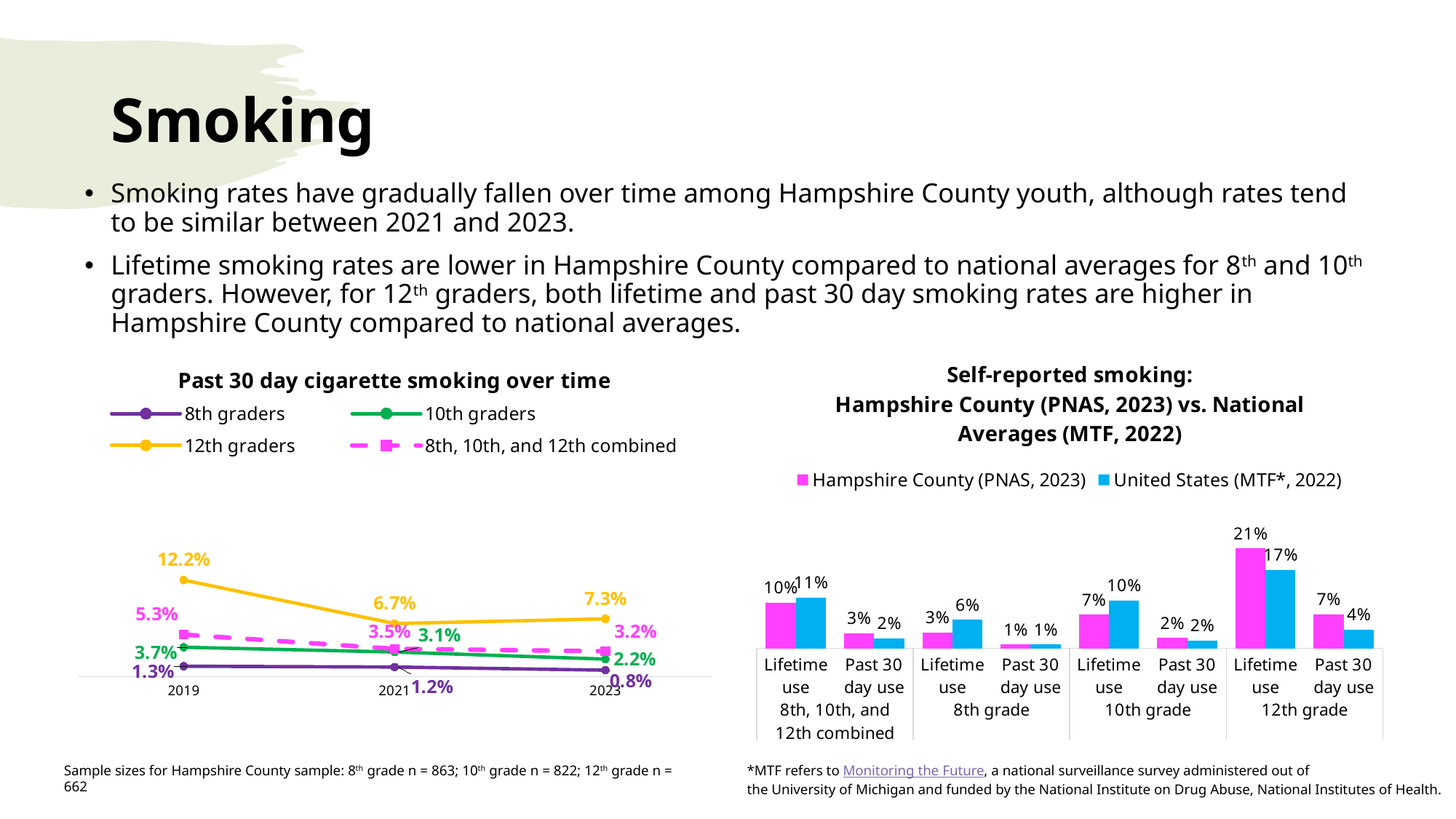
In the 'Past 30 day cigarette smoking over time' chart, how did the 12th graders' value change from 2019 to 2021? It fell In the 'Past 30 day cigarette smoking over time' chart, how many series does the legend list? 4 In the 'Past 30 day cigarette smoking over time' chart, what is the difference between the 12th graders' value in 2019 and in 2023? 4.9% In the 'Past 30 day cigarette smoking over time' chart, what was the value for 8th graders in 2023? 0.8% In the 'Past 30 day cigarette smoking over time' chart, what was the value for 8th, 10th, and 12th combined in 2021? 3.5% In the 'Self-reported smoking' chart, what is the difference between the United States and Hampshire County values for lifetime use among 10th grade? 3% In the 'Self-reported smoking' chart, which is larger for past 30 day use among 12th grade: Hampshire County (PNAS, 2023) or United States (MTF*, 2022)? Hampshire County (PNAS, 2023) In the 'Self-reported smoking' chart, what is the United States (MTF*, 2022) value for lifetime use among 8th grade? 6% What kind of chart is the 'Self-reported smoking' chart? Bar chart In the 'Past 30 day cigarette smoking over time' chart, what was the value for 12th graders in 2019? 12.2% In the 'Past 30 day cigarette smoking over time' chart, which series had the highest value in 2023? 12th graders In the 'Self-reported smoking' chart, what is the Hampshire County (PNAS, 2023) value for lifetime use among 12th grade? 21%